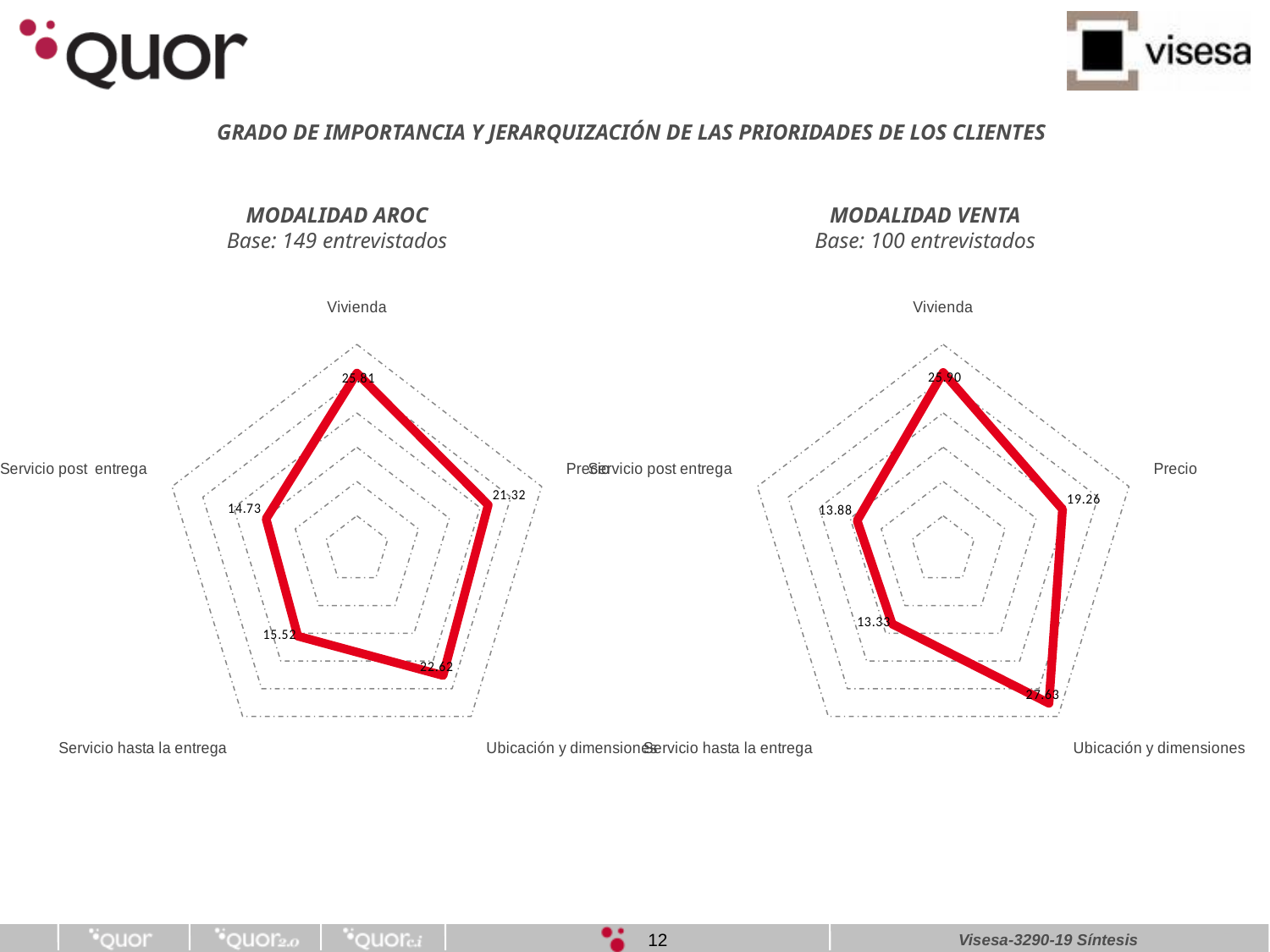
In the MODALIDAD VENTA chart, what is the difference between the values for Precio and Servicio post entrega? 5.38 What is the base (number of interviewees) stated for the MODALIDAD VENTA chart? 100 entrevistados In the MODALIDAD AROC chart, what is the difference between the values for Precio and Servicio post entrega? 6.59 In the MODALIDAD AROC chart, what is the value for Precio? 21.32 In the MODALIDAD AROC chart, which category has the highest value? Vivienda In the MODALIDAD VENTA chart, what is the value for Precio? 19.26 In the MODALIDAD AROC chart, what is the value for Servicio hasta la entrega? 15.52 What kind of chart is the MODALIDAD AROC chart? Radar chart Is the value for Precio larger in the MODALIDAD AROC chart or in the MODALIDAD VENTA chart? MODALIDAD AROC In the MODALIDAD VENTA chart, what is the value for Servicio post entrega? 13.88 In the MODALIDAD AROC chart, what is the value for Servicio post entrega? 14.73 How many categories does the MODALIDAD VENTA chart show? 5